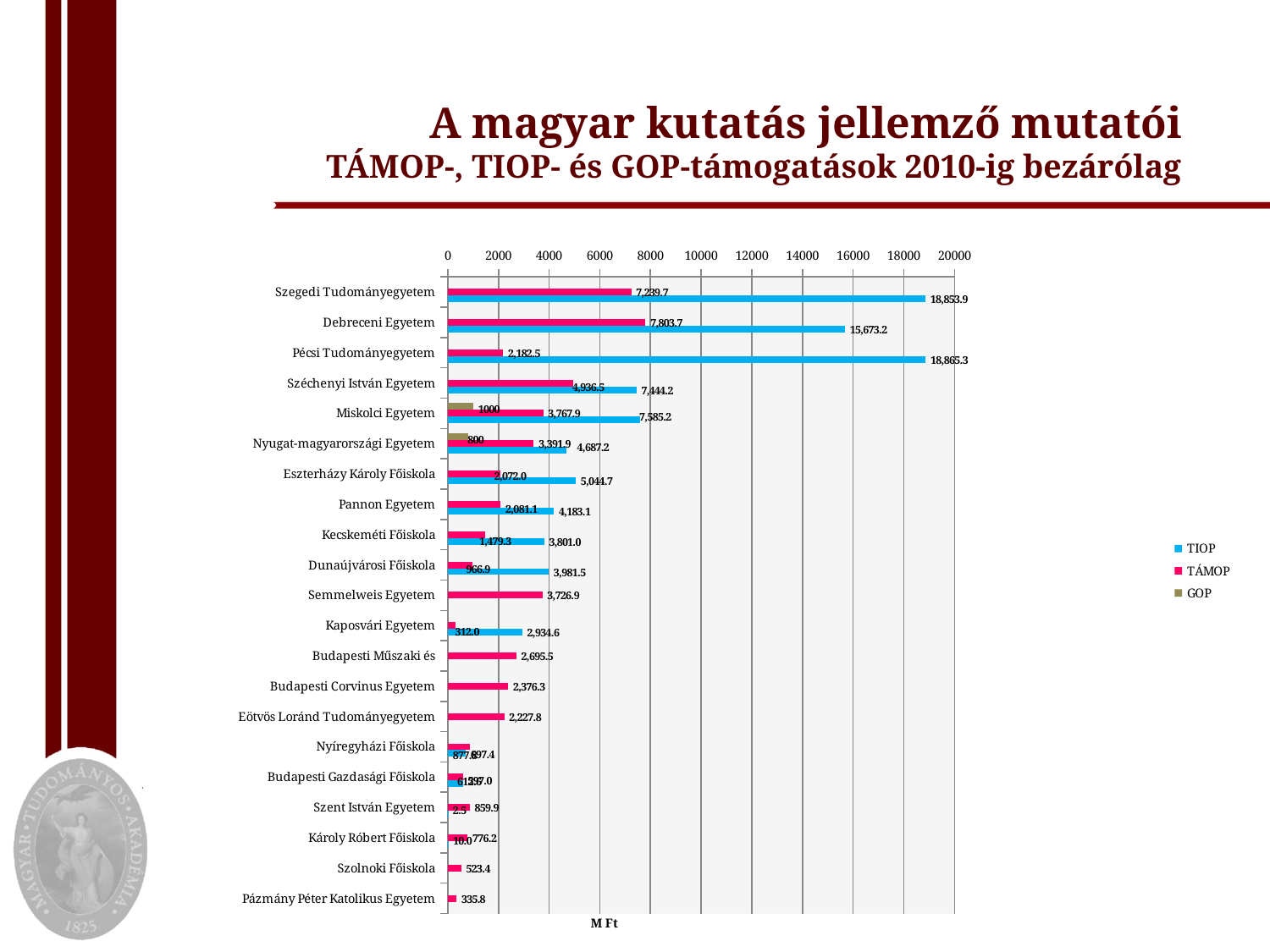
For Széchenyi István Egyetem, which is larger, the TIOP value or the TÁMOP value? TIOP Is the TIOP value for Debreceni Egyetem greater or less than 14000? greater What is the TIOP value for Pécsi Tudományegyetem? 18,865.3 What is the TÁMOP value for Szegedi Tudományegyetem? 7,239.7 How many series does the legend list? 3 What kind of chart is shown on the slide? Bar chart What is the difference between the TIOP and TÁMOP values for Miskolci Egyetem? 3,817.3 What is the difference between the TIOP and TÁMOP values for Szegedi Tudományegyetem? 11,614.2 What is the TÁMOP value for Semmelweis Egyetem? 3,726.9 How many institutions (categories) are shown on the chart? 21 What is the GOP value for Miskolci Egyetem? 1000 What is the TIOP value for Debreceni Egyetem? 15,673.2